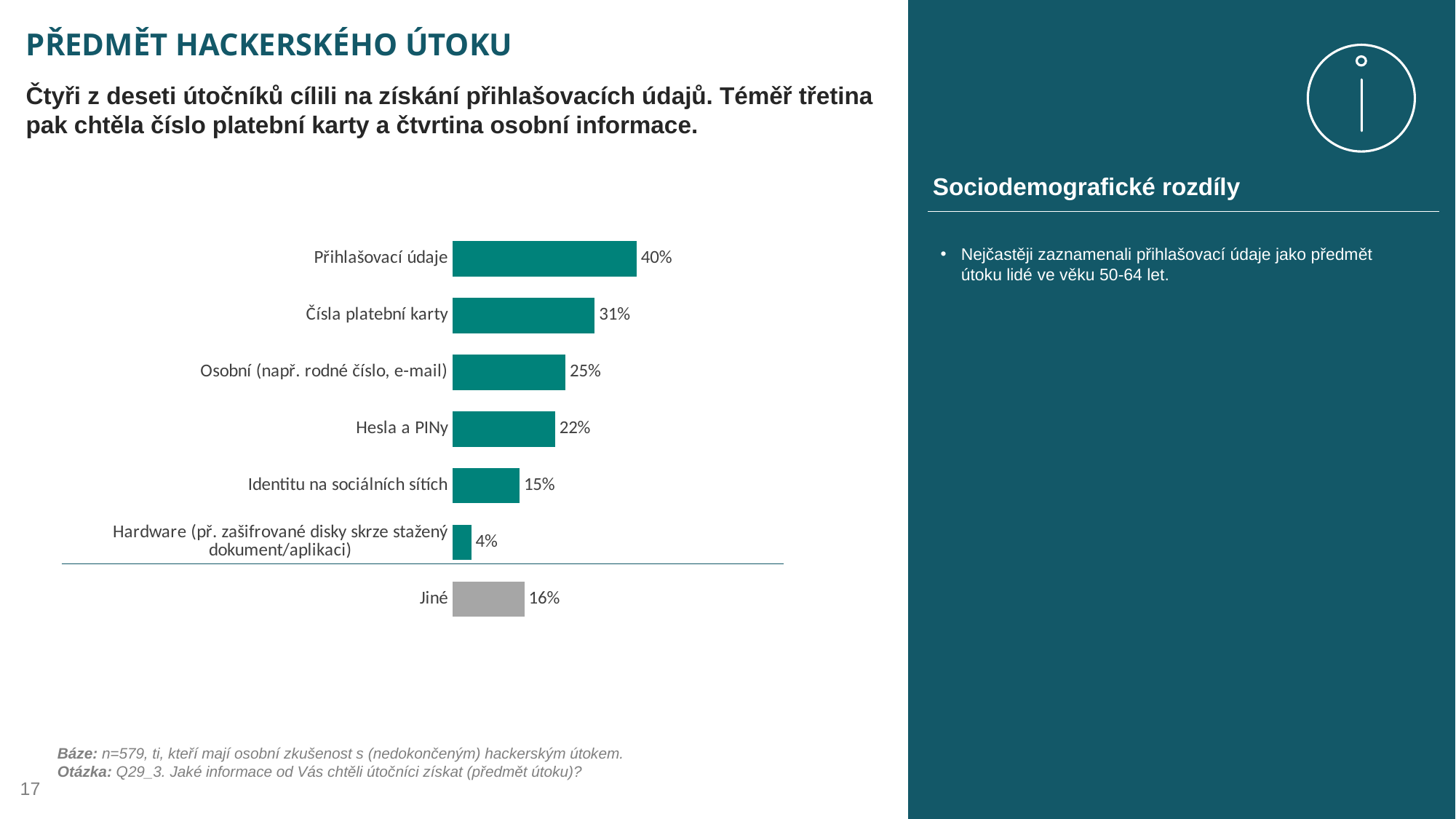
Which category has the highest value? Přihlašovací údaje What is the value for Přihlašovací údaje? 40% Which category has the lowest value? Hardware (př. zašifrované disky skrze stažený dokument/aplikaci) Which is larger, the value for Jiné or the value for Identitu na sociálních sítích? Jiné What is the difference between the values for Přihlašovací údaje and Čísla platební karty? 9% What kind of chart is shown on the slide? Bar chart What is the value for Hesla a PINy? 22% Which bar is shown in a different colour (grey) from the others? Jiné How many categories are shown in the chart? 7 What is the value for Čísla platební karty? 31% What is the value for Jiné? 16% What is the difference between the values for Osobní (např. rodné číslo, e-mail) and Identitu na sociálních sítích? 10%